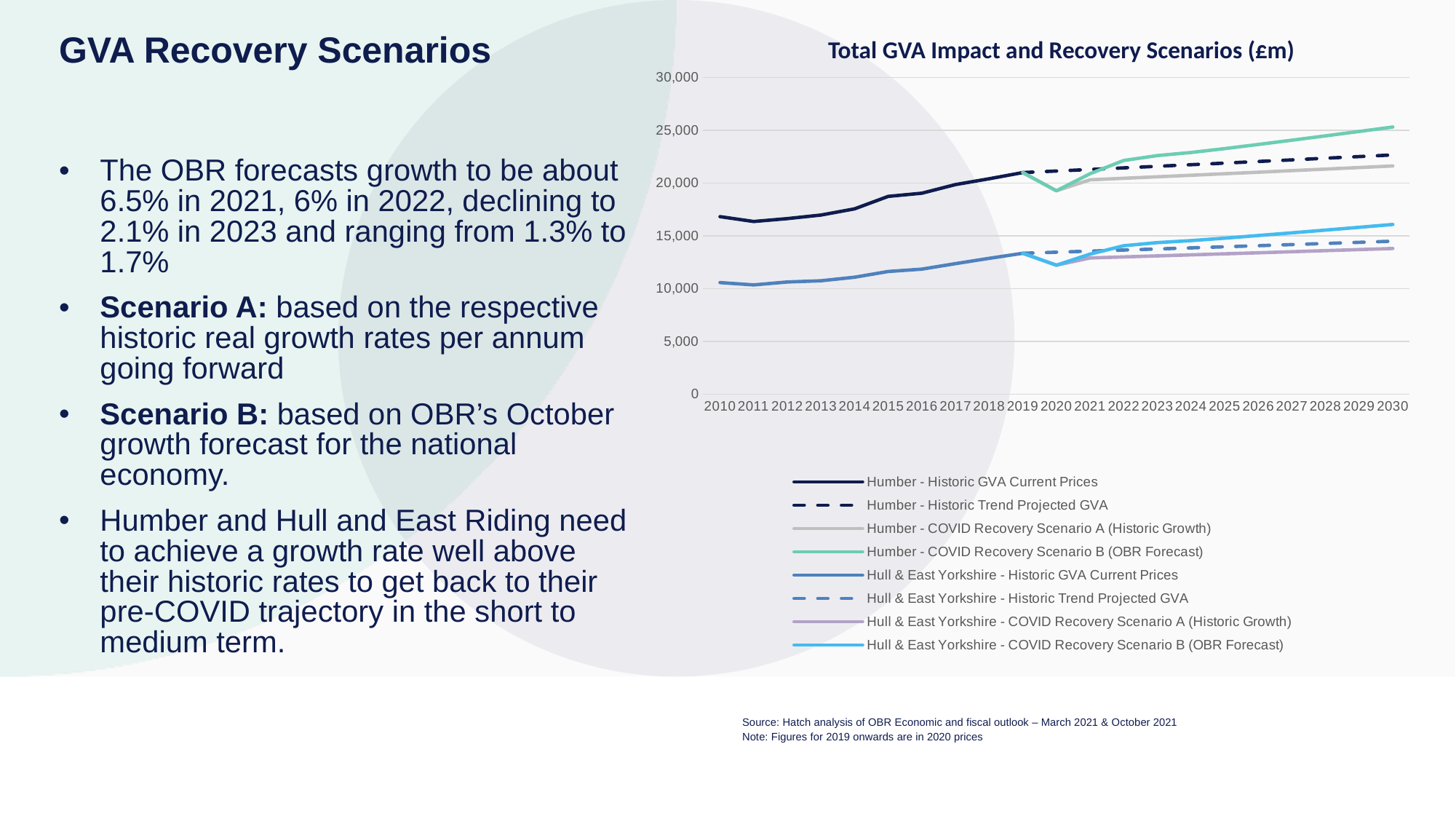
Is the value for Humber - COVID Recovery Scenario B (OBR Forecast) in 2030 greater or less than 20,000? greater What is the title of the chart? Total GVA Impact and Recovery Scenarios (£m) Does the Humber - Historic GVA Current Prices line rise or fall between 2010 and 2019? Rises Is the value for Humber - Historic GVA Current Prices in 2010 greater or less than 15,000? greater In 2030, which is higher: Humber - COVID Recovery Scenario A (Historic Growth) or Humber - COVID Recovery Scenario B (OBR Forecast)? Humber - COVID Recovery Scenario B (OBR Forecast) Which series reaches the highest value in 2030? Humber - COVID Recovery Scenario B (OBR Forecast) How many series does the chart's legend list? 8 What kind of chart is shown on the slide? Line chart How many years are shown along the x axis of the chart? 21 Is the value for Hull & East Yorkshire - COVID Recovery Scenario A (Historic Growth) in 2020 greater or less than 15,000? less Which series is drawn as a dashed dark navy line? Humber - Historic Trend Projected GVA